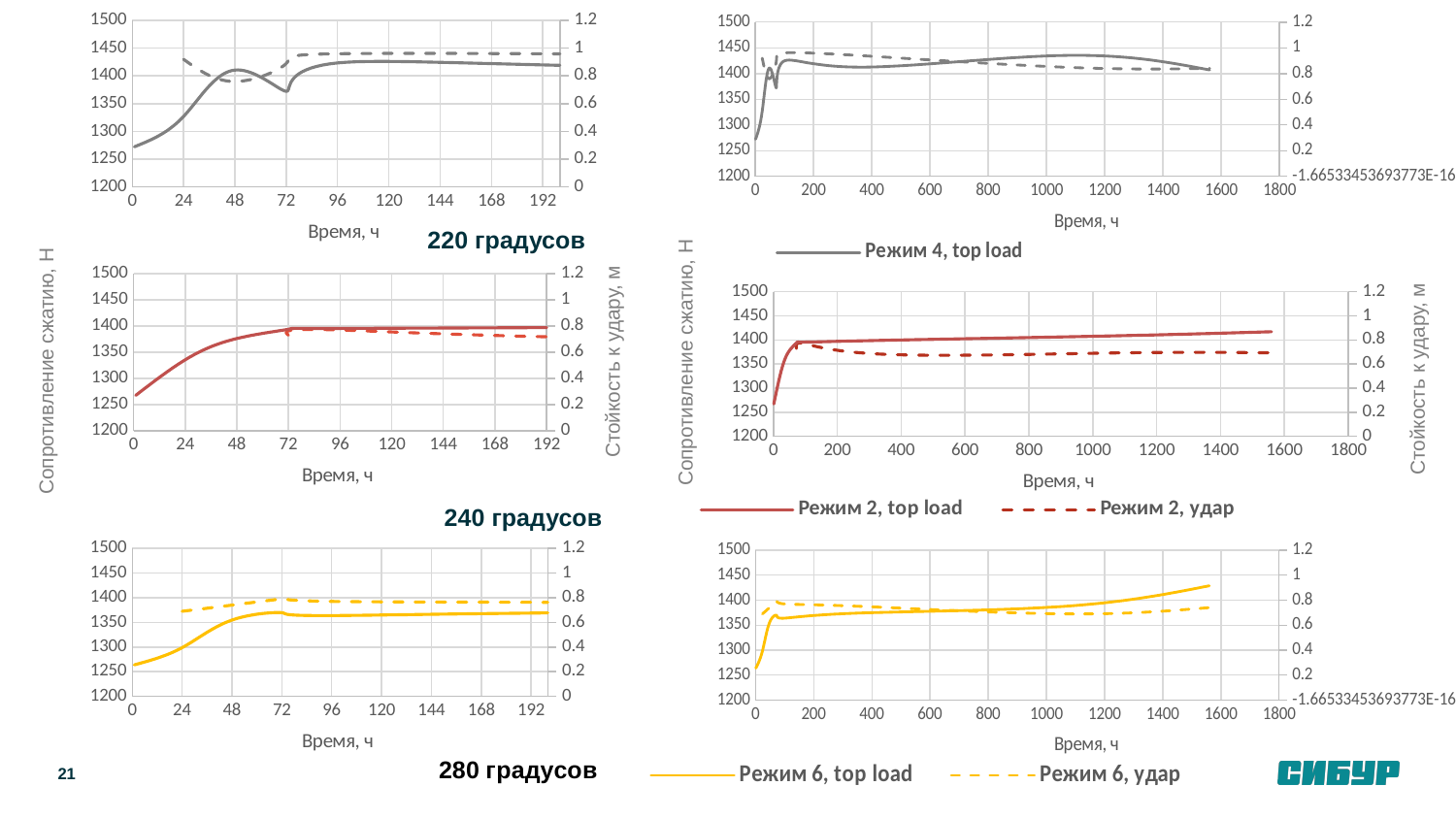
In the top-right chart (Режим 4, top load), is the value of the solid line at about 1100 hours greater or less than 1400? greater How many charts are shown on the slide? 6 In the middle-right chart, does the "Режим 2, top load" line rise or fall overall from 0 to 1600 hours? rises In the top-left chart (220 градусов), is the value of the solid line at time 0 greater or less than 1300? less In the bottom-right chart, is the value of the "Режим 6, top load" line at its right end (about 1550 hours) greater or less than 1400? greater In the bottom-right chart, does the "Режим 6, top load" line rise or fall between 200 and 1600 hours? rises How many series does the legend of the top-right chart (Режим 4) list? 1 What kind of chart is the top-left chart labelled "220 градусов"? line chart How many series does the legend of the middle-right chart (Режим 2) list? 2 What is the highest x-axis tick value on the three charts in the right column? 1800 What is the x-axis label on the charts? Время, ч